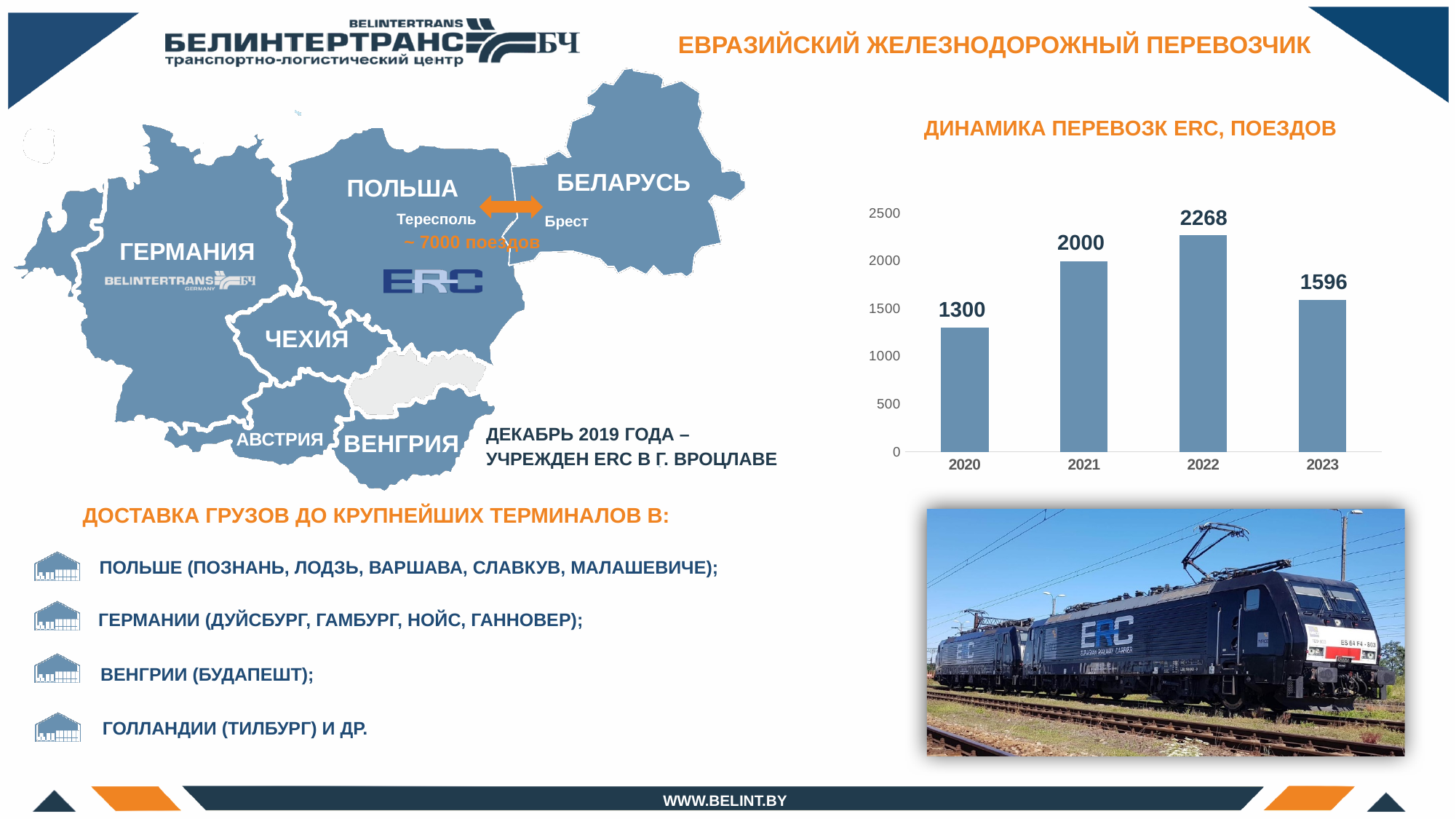
Is the value for 2023 greater or less than 1500? greater What is the difference between the values for 2022 and 2023? 672 Which year has the lowest value in the chart? 2020 What is the value for 2022 in the chart? 2268 Which year has the highest value in the chart? 2022 Which is larger, the value for 2021 or the value for 2023? 2021 What kind of chart is shown on the slide? bar chart What is the title of the chart on the slide? ДИНАМИКА ПЕРЕВОЗК ERC, ПОЕЗДОВ What is the value for 2020 in the chart 'ДИНАМИКА ПЕРЕВОЗК ERC, ПОЕЗДОВ'? 1300 What is the difference between the values for 2021 and 2020? 700 How many years are shown on the x axis of the chart? 4 What is the value for 2023 in the chart? 1596